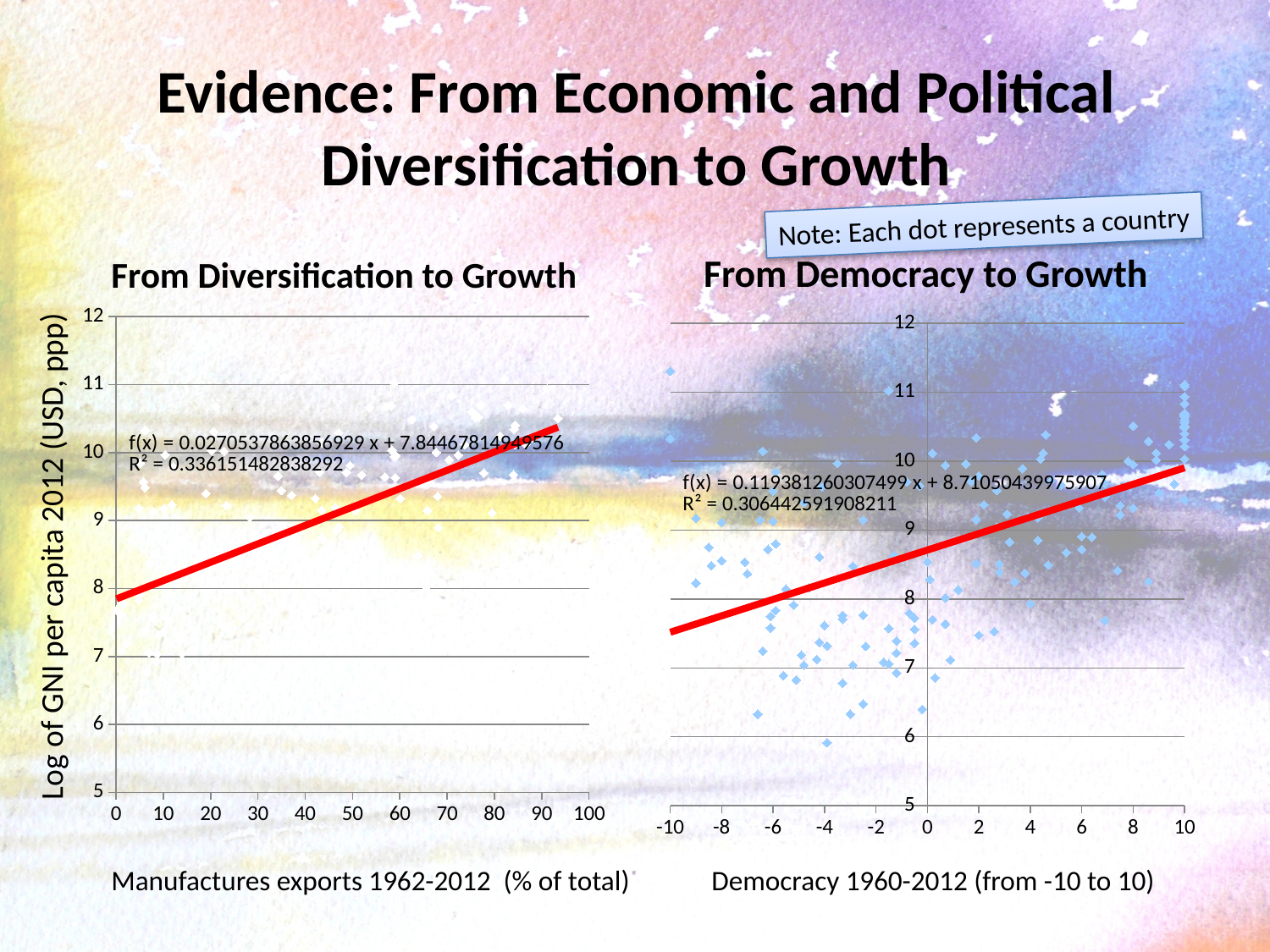
What is the x-axis label of the 'From Democracy to Growth' chart? Democracy 1960-2012 (from -10 to 10) What is the R² value shown on the 'From Democracy to Growth' chart? 0.306442591908211 What is the slope of the fitted line in the 'From Diversification to Growth' chart? 0.0270537863856929 In the 'From Diversification to Growth' chart, what is the highest value shown on the x axis? 100 What is the R² value shown on the 'From Diversification to Growth' chart? 0.336151482838292 What is the intercept of the fitted line in the 'From Democracy to Growth' chart? 8.71050439975907 What kind of chart is the 'From Democracy to Growth' chart? Scatter chart In the 'From Diversification to Growth' chart, does the red trend line rise or fall as manufactures exports increase? Rises Which chart has the higher R² value, 'From Diversification to Growth' or 'From Democracy to Growth'? From Diversification to Growth What kind of chart is the 'From Diversification to Growth' chart? Scatter chart In the 'From Democracy to Growth' chart, does the red trend line rise or fall as the democracy score increases? Rises What is the y-axis label shared by the two charts? Log of GNI per capita 2012 (USD, ppp)